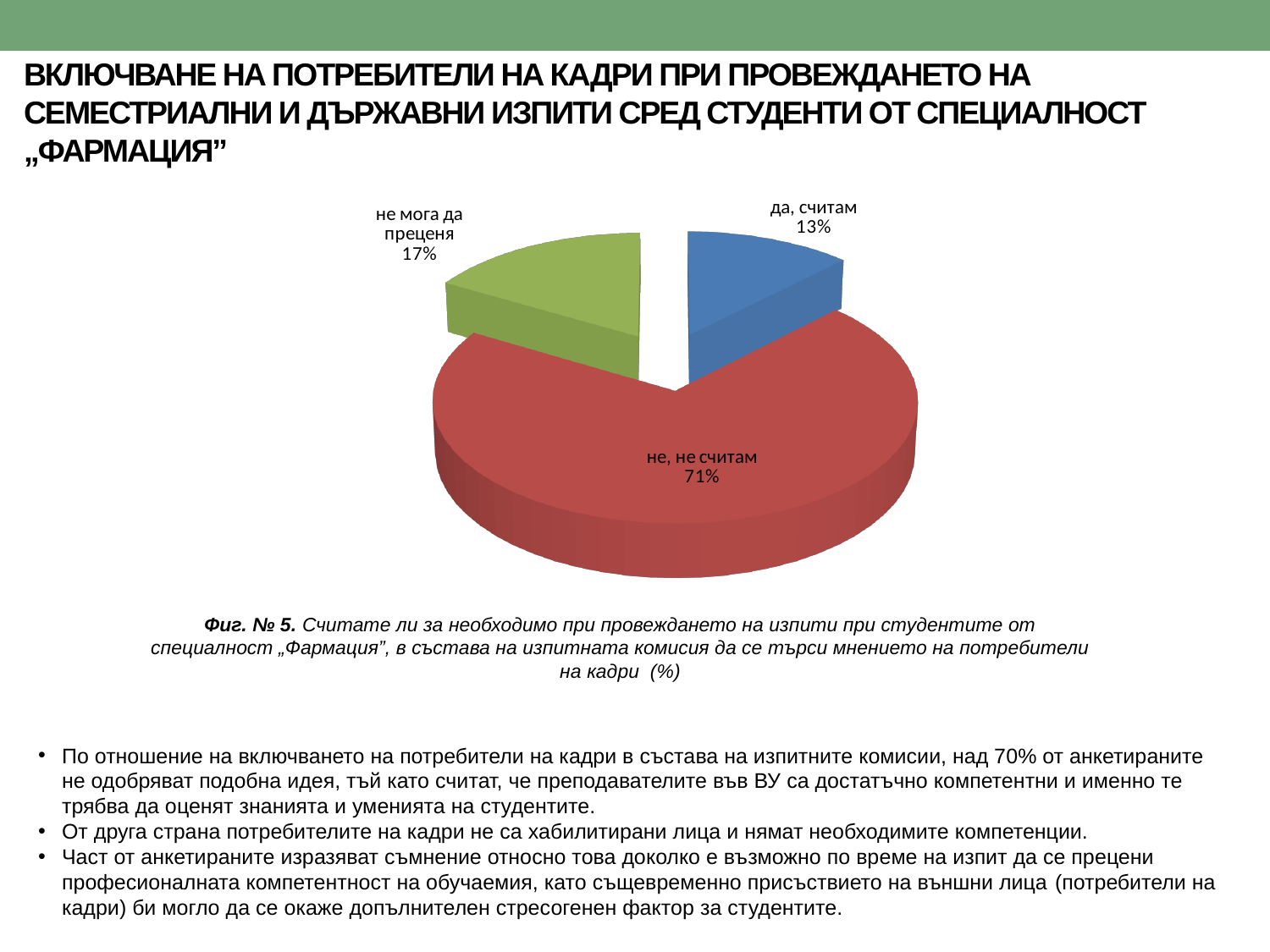
What is the difference in percentage points between "не, не считам" and "да, считам"? 58 What colour is the slice for "не, не считам"? red What share of the pie does "не, не считам" have? 71% Which category has the smallest slice of the pie? да, считам Which category has the largest slice of the pie? не, не считам What share of the pie does "да, считам" have? 13% Which is larger, the share for "не мога да преценя" or the share for "да, считам"? не мога да преценя What type of chart is shown on the slide? pie chart What is the difference in percentage points between "не мога да преценя" and "да, считам"? 4 How many slices does the pie chart have? 3 What share of the pie does "не мога да преценя" have? 17% What colour is the slice for "не мога да преценя"? green